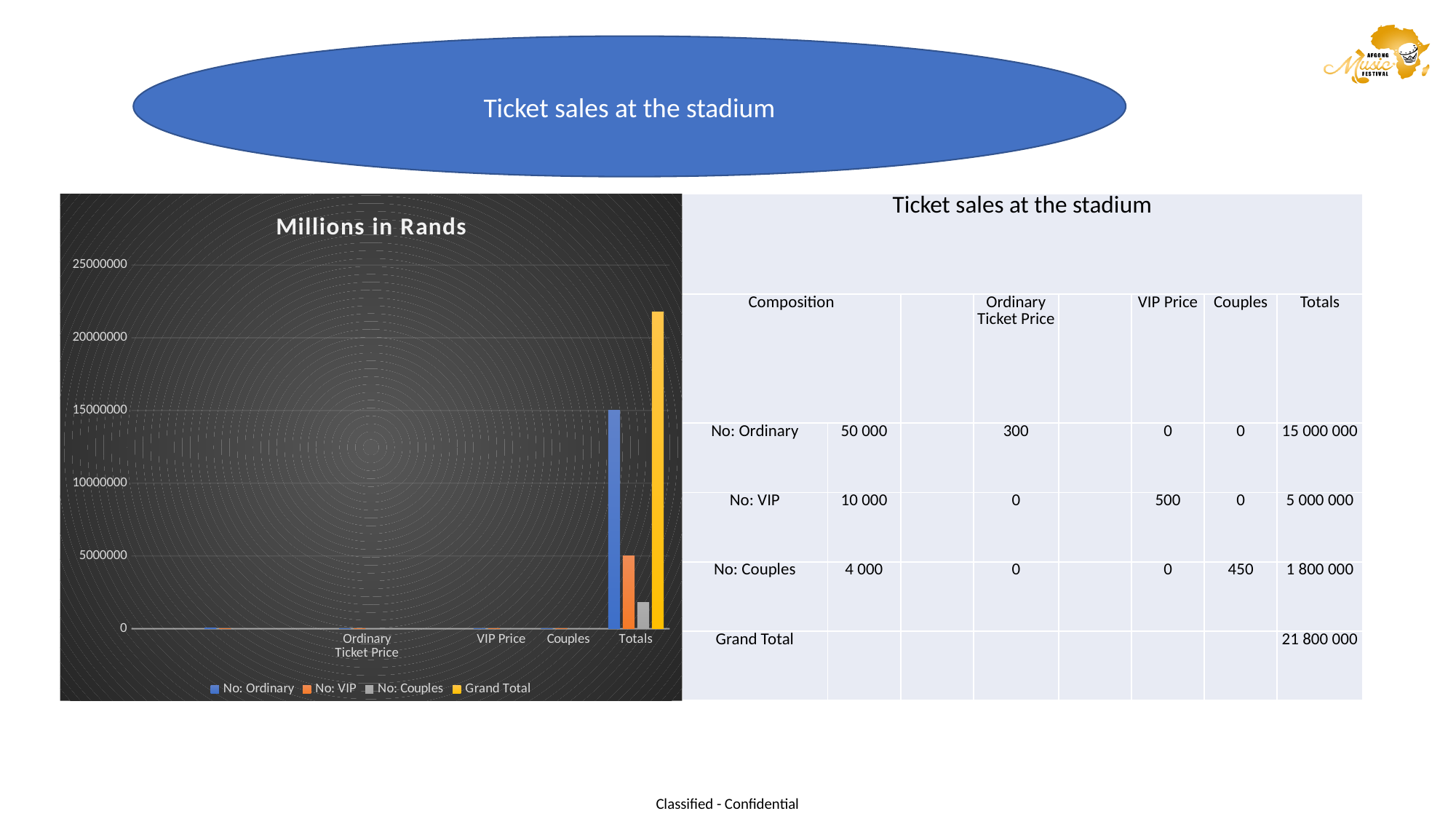
What is the No: Ordinary value in the Totals category? 15000000 In the Totals category, which series has the shortest bar? No: Couples How many series does the chart legend list? 4 What is the title of the chart? Millions in Rands What colour represents the Grand Total series in the chart? yellow Is the Grand Total value in the Totals category greater or less than 20000000? greater In the Totals category, which is larger: Grand Total or No: Ordinary? Grand Total In the Totals category, which series has the tallest bar? Grand Total In the Totals category, which is larger: No: Ordinary or No: VIP? No: Ordinary Is the No: Couples value in the Totals category greater or less than 5000000? less Is the No: VIP value in the Totals category greater or less than 10000000? less What kind of chart is shown on the slide? bar chart